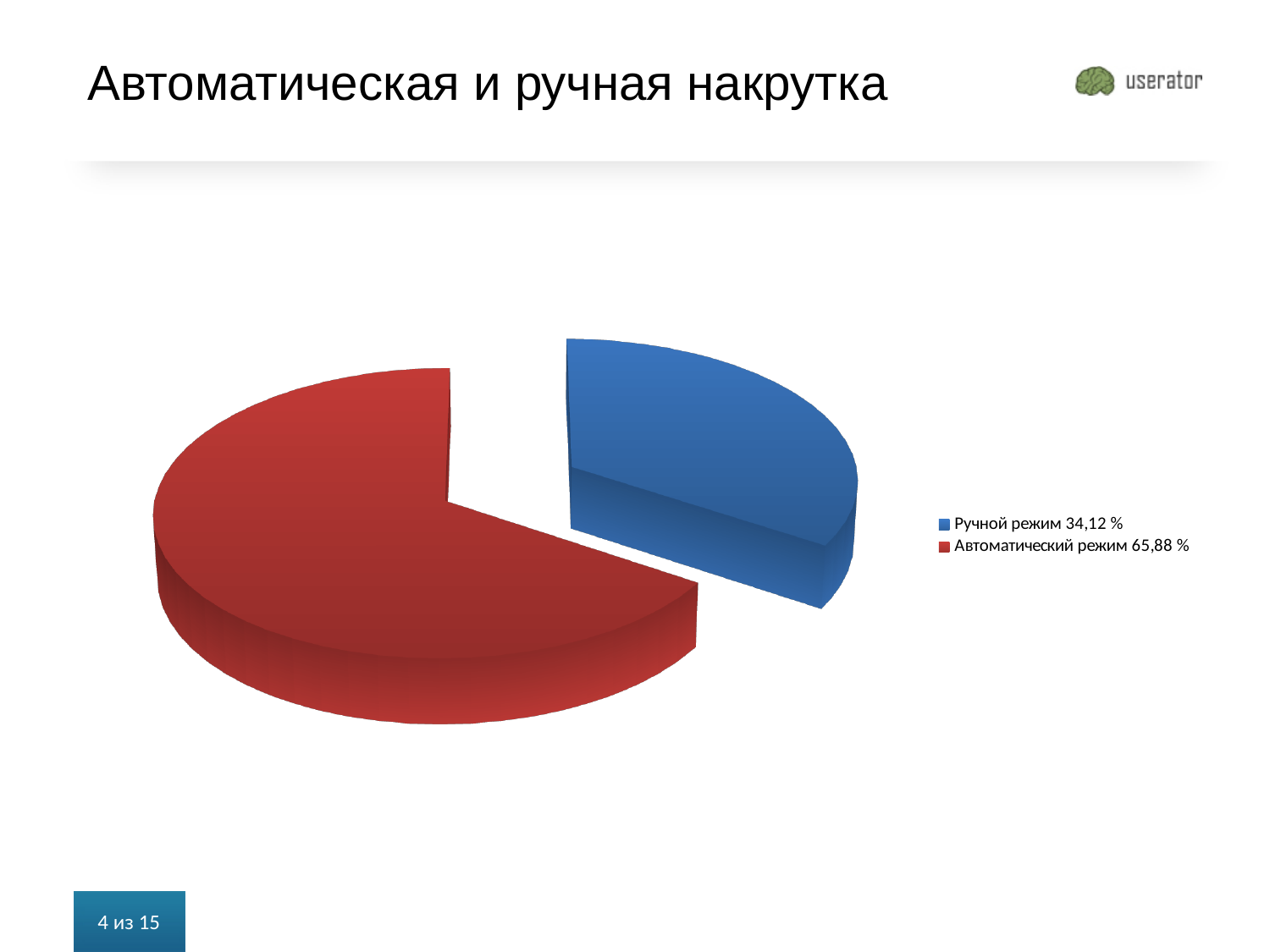
Which is larger, the share for Ручной режим or the share for Автоматический режим? Автоматический режим What is the difference in percentage points between the Автоматический режим share and the Ручной режим share? 31,76 What share of the pie does Ручной режим have? 34,12 % Which slice of the pie is the largest? Автоматический режим What kind of chart is shown on the slide? Pie chart What colour is the slice for Ручной режим? Blue What colour is the slice for Автоматический режим? Red How many slices does the pie chart have? 2 What share of the pie does Автоматический режим have? 65,88 % How many entries does the legend list? 2 Which slice of the pie is the smallest? Ручной режим